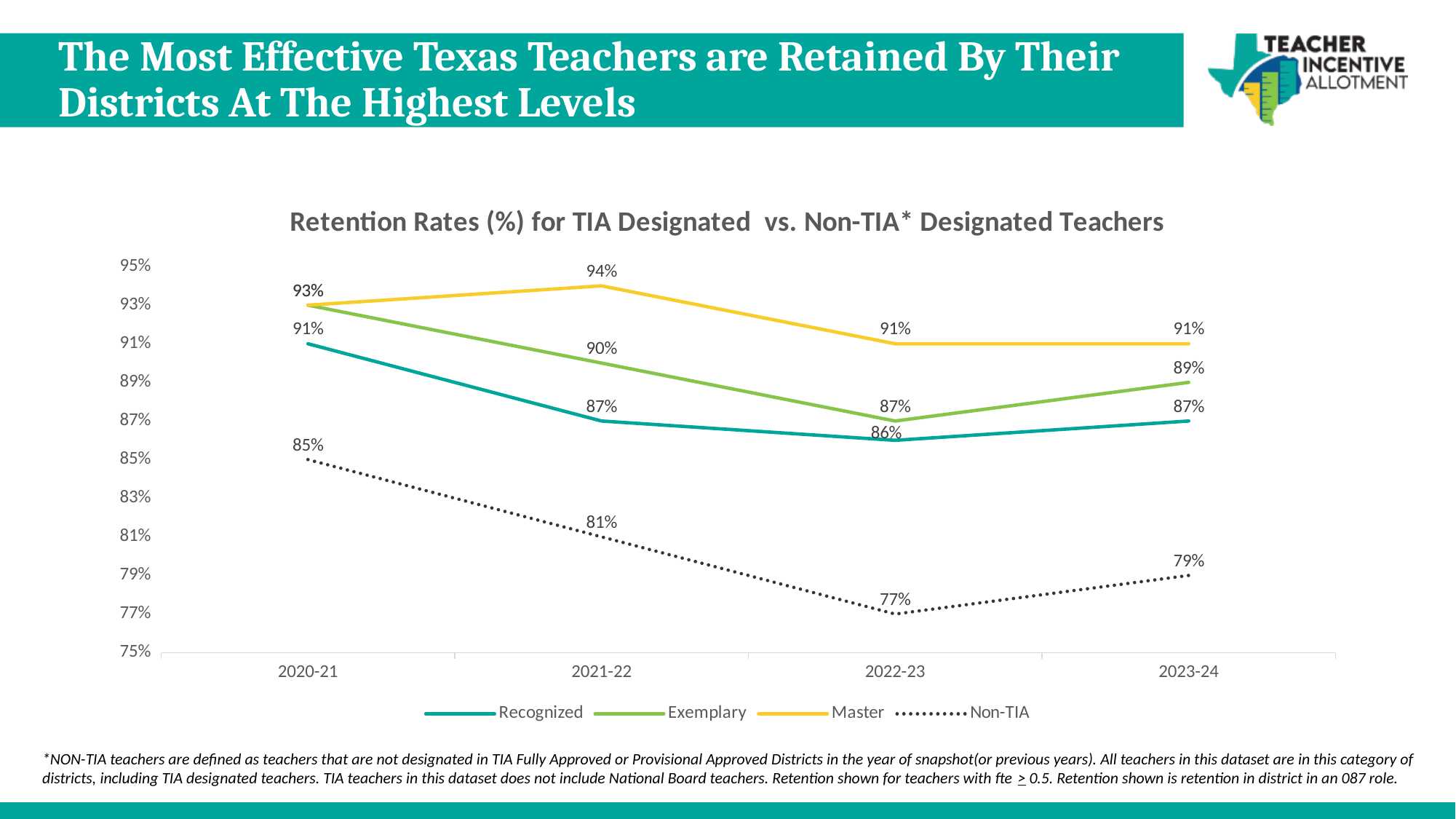
What was the retention rate for Recognized teachers in 2023-24? 87% What type of chart is shown on the slide? Line chart What was the retention rate for Non-TIA teachers in 2022-23? 77% In which school year was the Non-TIA retention rate lowest? 2022-23 Did the Non-TIA retention rate rise or fall from 2020-21 to 2022-23? Fall In 2021-22, which had the higher retention rate, Exemplary or Recognized teachers? Exemplary What is the difference between the Master and Non-TIA retention rates in 2023-24? 12 percentage points How many school years are shown on the x axis? 4 Which series had the highest retention rate in 2021-22? Master What was the retention rate for Master teachers in 2021-22? 94% How many series does the legend list? 4 What was the retention rate for Exemplary teachers in 2023-24? 89%